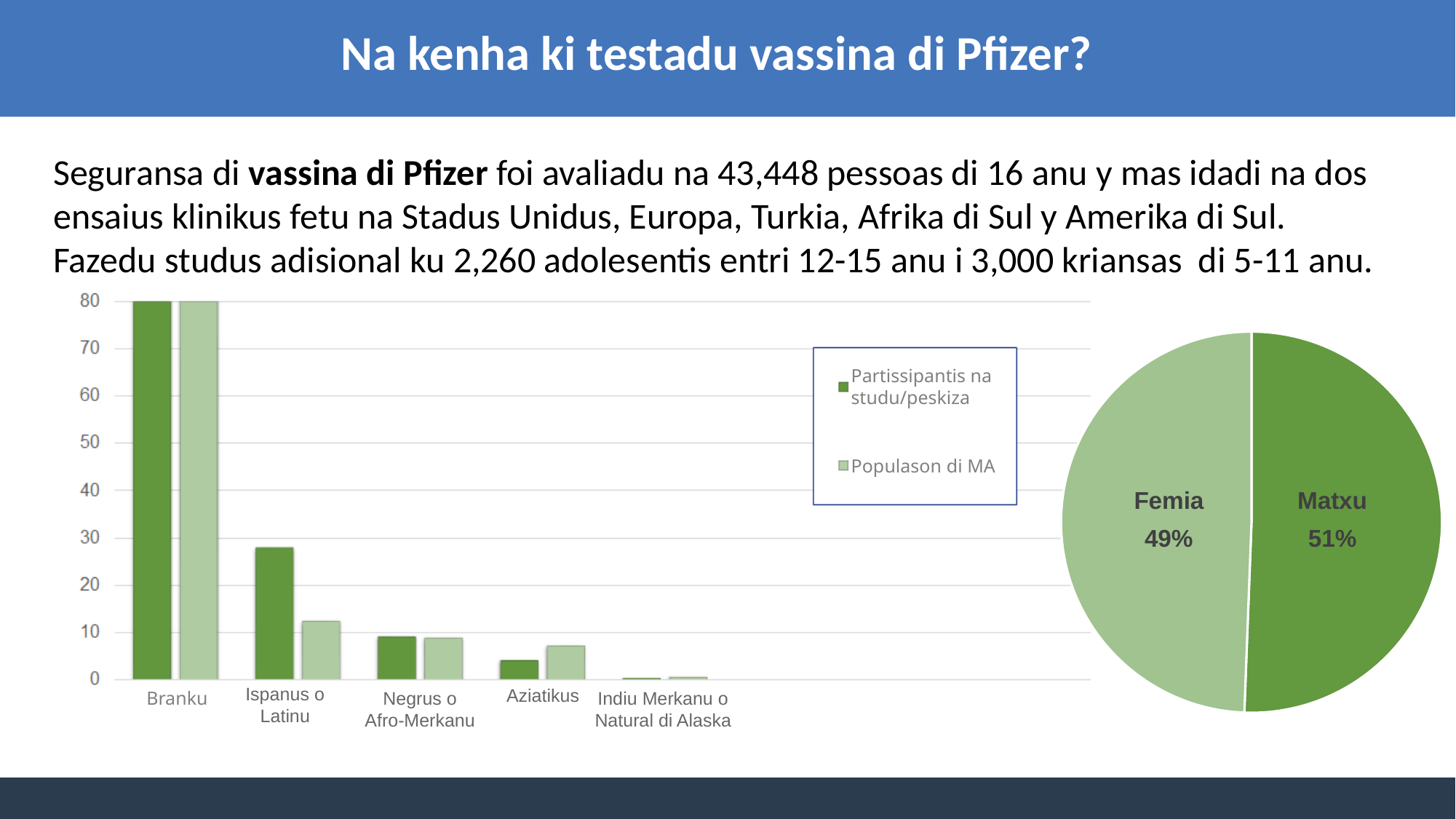
In the bar chart on the left, which category has the lowest value for Partissipantis na studu/peskiza? Indiu Merkanu o Natural di Alaska In the bar chart on the left, how many categories are shown on the x axis? 5 In the bar chart on the left, how many series does the legend list? 2 What kind of chart is the chart on the left of the slide? bar chart In the bar chart on the left, for Aziatikus, which series has the larger value: Partissipantis na studu/peskiza or Populason di MA? Populason di MA In the bar chart on the left, which category has the highest value for Partissipantis na studu/peskiza? Branku What kind of chart is the chart on the right of the slide? pie chart In the bar chart on the left, is the Partissipantis na studu/peskiza value for Ispanus o Latinu greater or less than 20? greater In the pie chart on the right, what share is shown for Matxu? 51% In the pie chart on the right, which slice is larger: Femia or Matxu? Matxu In the pie chart on the right, what share is shown for Femia? 49% In the bar chart on the left, is the Populason di MA value for Ispanus o Latinu greater or less than 20? less